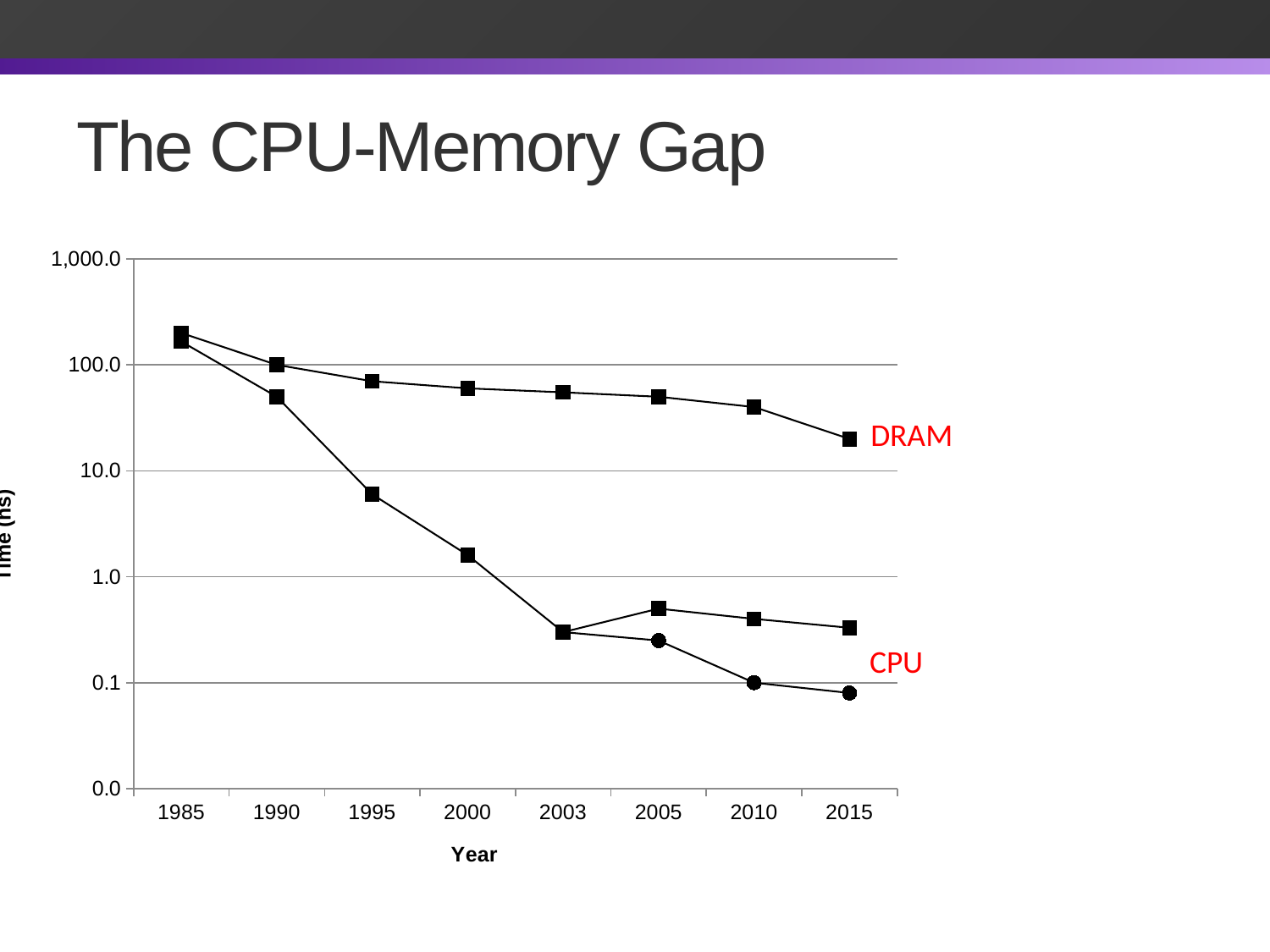
What is the title of the chart? The CPU-Memory Gap Do the DRAM values rise or fall from 1985 to 2015? fall Which year has the lowest DRAM value? 2015 What is the title of the x axis? Year What kind of chart is shown on the slide? line chart Is the DRAM value for 1985 greater or less than 100? greater Which year has the highest DRAM value? 1985 Is the DRAM value for 2015 greater or less than 100? less Is the DRAM value for 2015 greater or less than 10? greater In 2015, which is larger, the DRAM value or the CPU value? DRAM How many years are marked along the x axis? 8